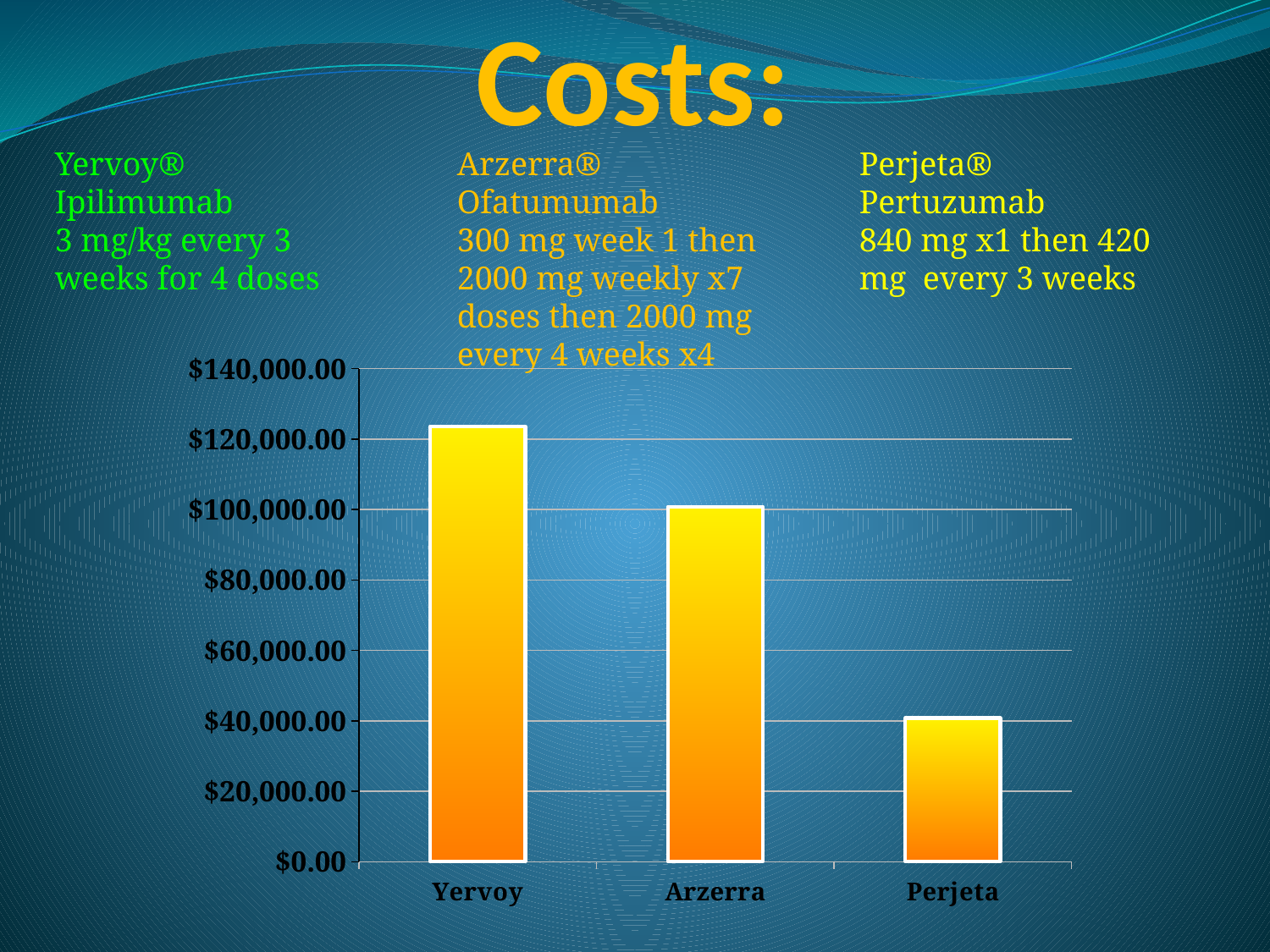
What is the title of the slide containing the chart? Costs: How many drugs are compared in the chart? 3 Do the bar values rise or fall from left to right across the chart? fall Is the cost for Perjeta greater or less than $20,000.00? greater Is the cost for Yervoy greater or less than $100,000.00? greater Which has a higher cost, Yervoy or Arzerra? Yervoy Is the cost for Arzerra greater or less than $120,000.00? less Which drug has the highest cost in the chart? Yervoy What type of chart is shown on the slide? bar chart Which drug has the lowest cost in the chart? Perjeta Which has a lower cost, Arzerra or Perjeta? Perjeta